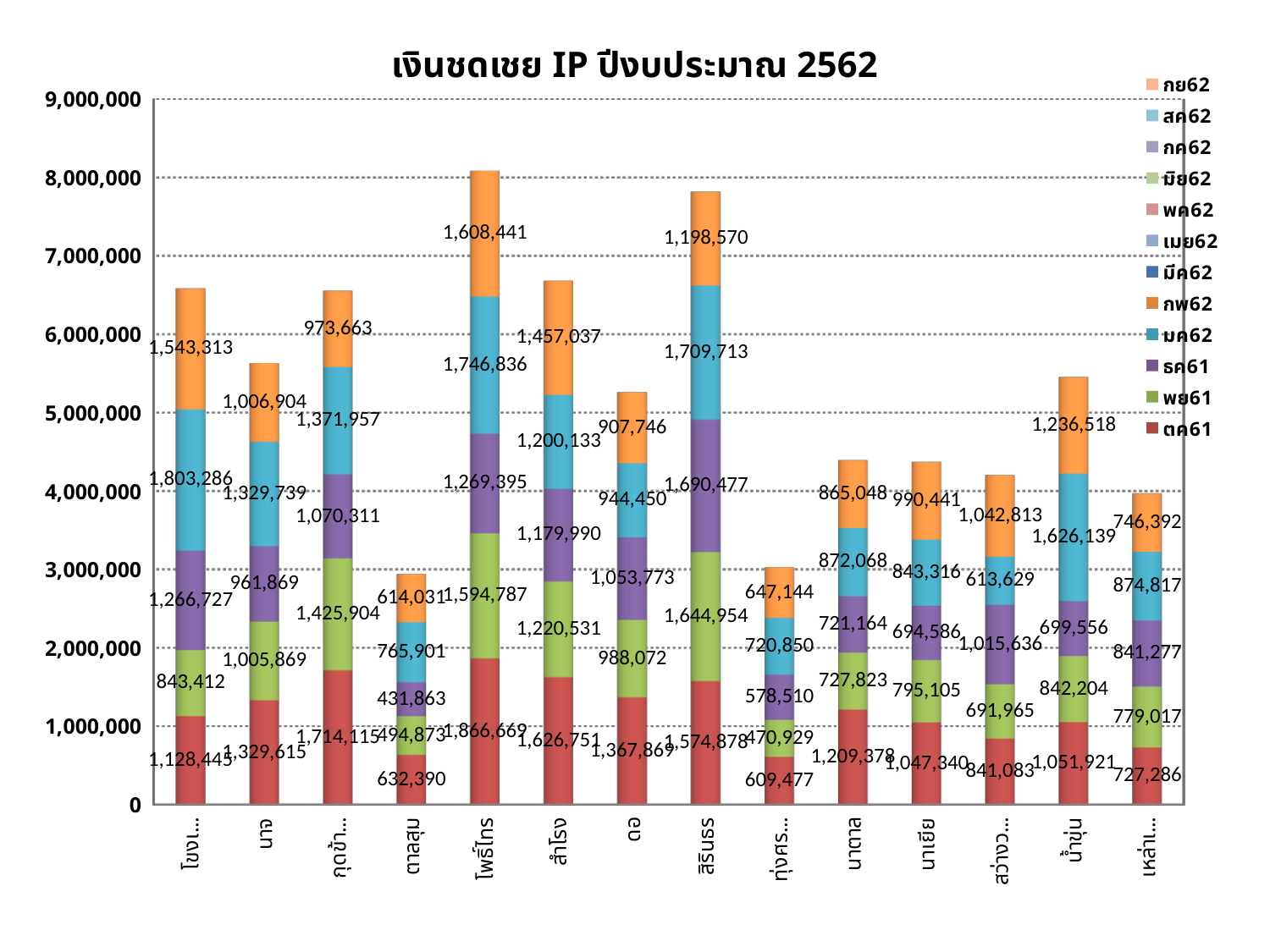
What is the title of the chart? เงินชดเชย IP ปีงบประมาณ 2562 What is the ตค61 value for โพธิ์ไทร? 1,866,669 Which has the larger มค62 value, น้ำขุ่น or นาตาล? น้ำขุ่น Is the total of the stacked bar for สิรินธร greater or less than 7,000,000? greater How many categories are shown on the x axis? 14 What is the กพ62 value for น้ำขุ่น? 1,236,518 What is the difference between the ตค61 value for นาจ and the ตค61 value for ตาลสุม? 697,225 How many series does the legend list? 12 What kind of chart is shown on the slide? stacked bar chart What is the มค62 value for สิรินธร? 1,709,713 What is the total of the stacked bar for ตาลสุม? 2,939,058 Which category has the tallest stacked bar? โพธิ์ไทร